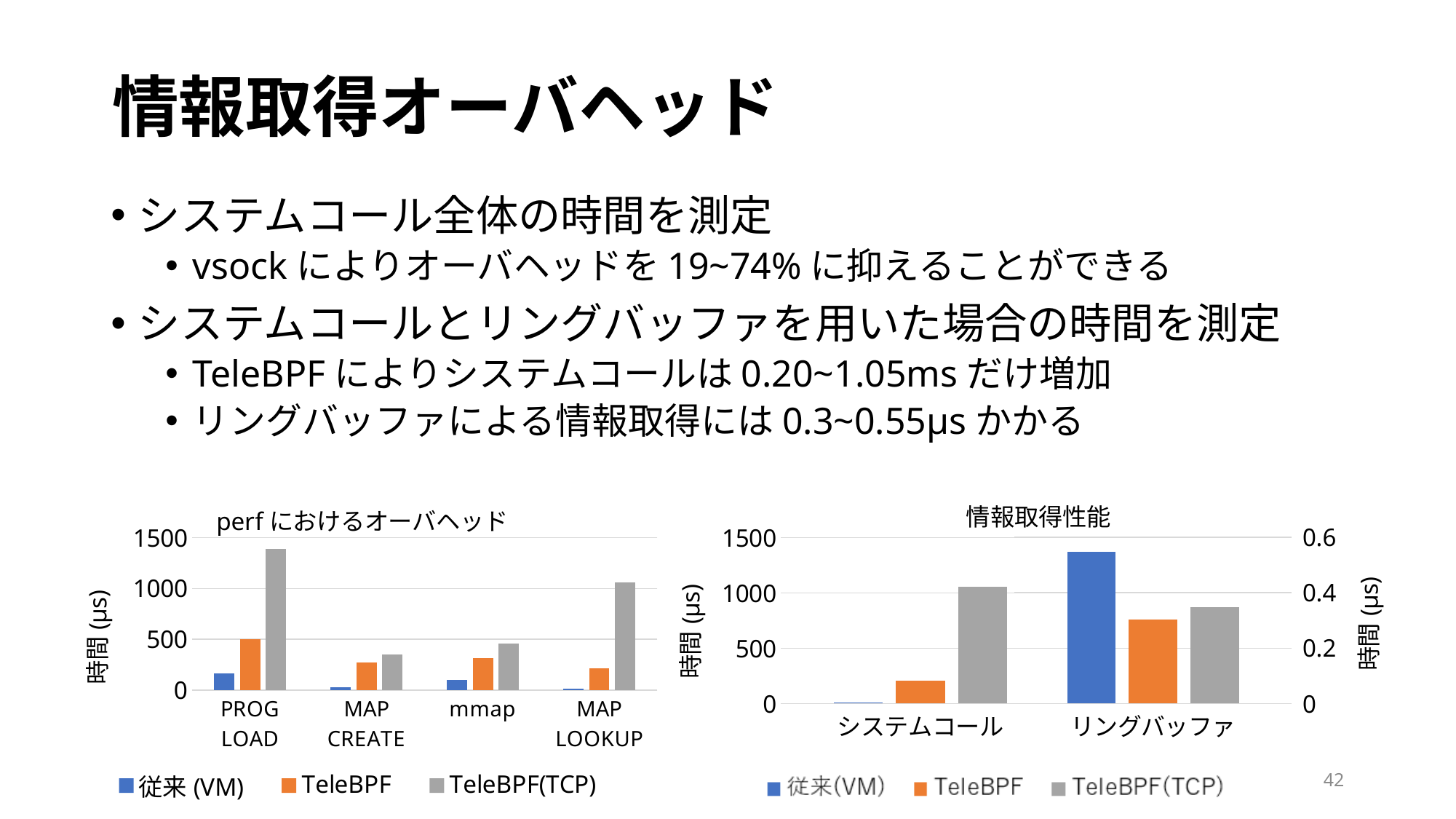
In the chart titled 'perf におけるオーバヘッド', is the TeleBPF value for MAP CREATE greater or less than 500? less In the chart titled '情報取得性能', which series has the tallest bar for システムコール? TeleBPF(TCP) What is the label of the left vertical axis of the chart titled 'perf におけるオーバヘッド'? 時間 (µs) In the chart titled 'perf におけるオーバヘッド', what kind of chart is shown? bar chart In the chart titled 'perf におけるオーバヘッド', which category has the highest 従来 (VM) value? PROG LOAD In the chart titled 'perf におけるオーバヘッド', is the TeleBPF(TCP) value for PROG LOAD greater or less than 1000? greater In the chart titled 'perf におけるオーバヘッド', which category has the highest TeleBPF(TCP) value? PROG LOAD In the chart titled '情報取得性能', how many categories are shown on the x axis? 2 In the chart titled 'perf におけるオーバヘッド', how many series does the legend list? 3 In the chart titled 'perf におけるオーバヘッド', how many categories are shown on the x axis? 4 In the chart titled 'perf におけるオーバヘッド', which is larger for mmap: the TeleBPF value or the TeleBPF(TCP) value? TeleBPF(TCP)